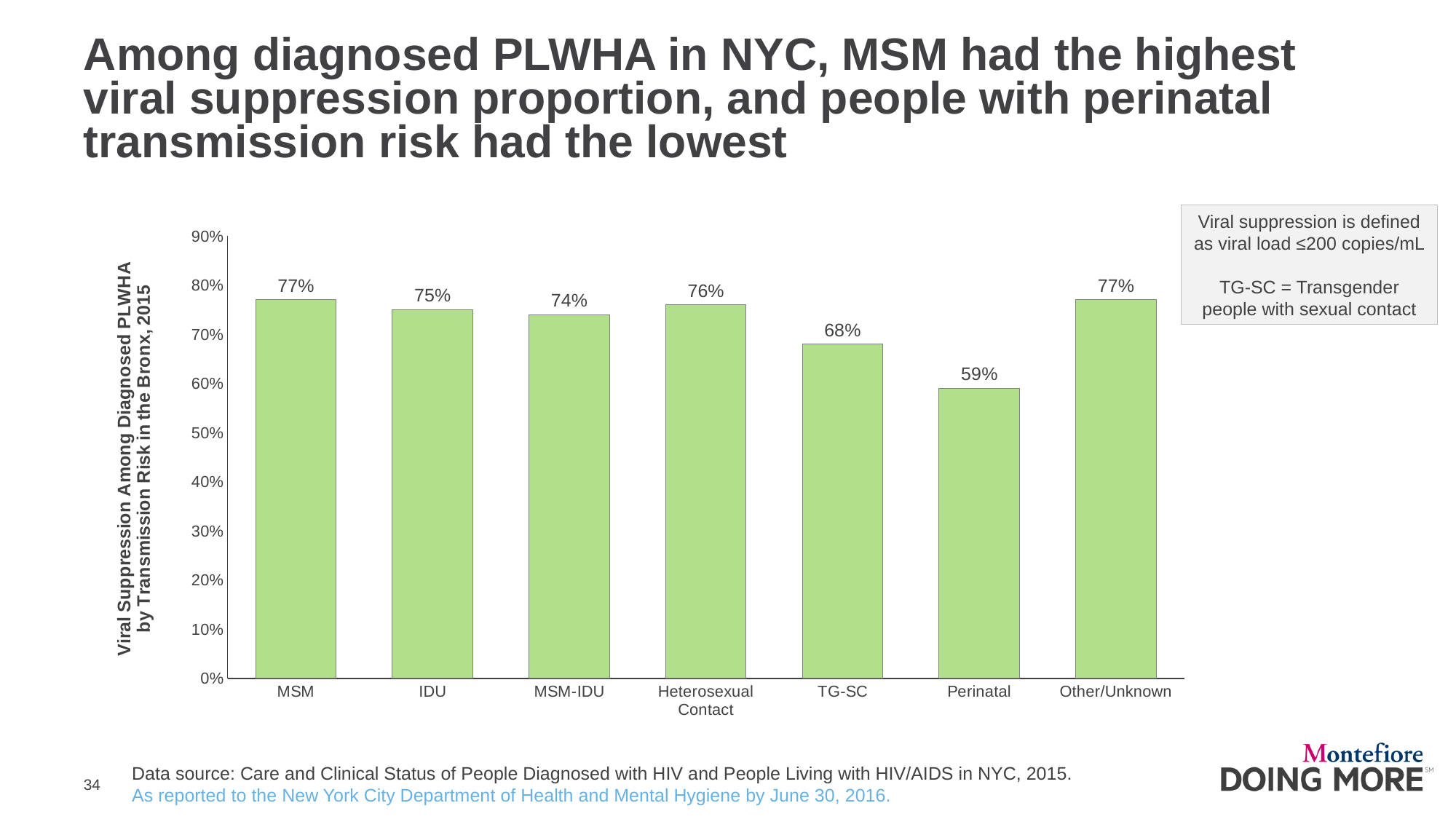
Which transmission risk category has the lowest viral suppression proportion? Perinatal How many transmission risk categories are shown on the chart? 7 What is the viral suppression proportion for MSM? 77% Is the value for Perinatal greater or less than 60%? less What is the viral suppression proportion for Perinatal transmission risk? 59% What is the y-axis label of the chart? Viral Suppression Among Diagnosed PLWHA by Transmission Risk in the Bronx, 2015 What is the viral suppression proportion for Heterosexual Contact? 76% What is the difference in viral suppression proportion between MSM and Perinatal? 18% Which has a higher viral suppression proportion, IDU or TG-SC? IDU What kind of chart is shown on the slide? Bar chart What is the viral suppression proportion for TG-SC? 68% What is the difference in viral suppression proportion between Heterosexual Contact and TG-SC? 8%